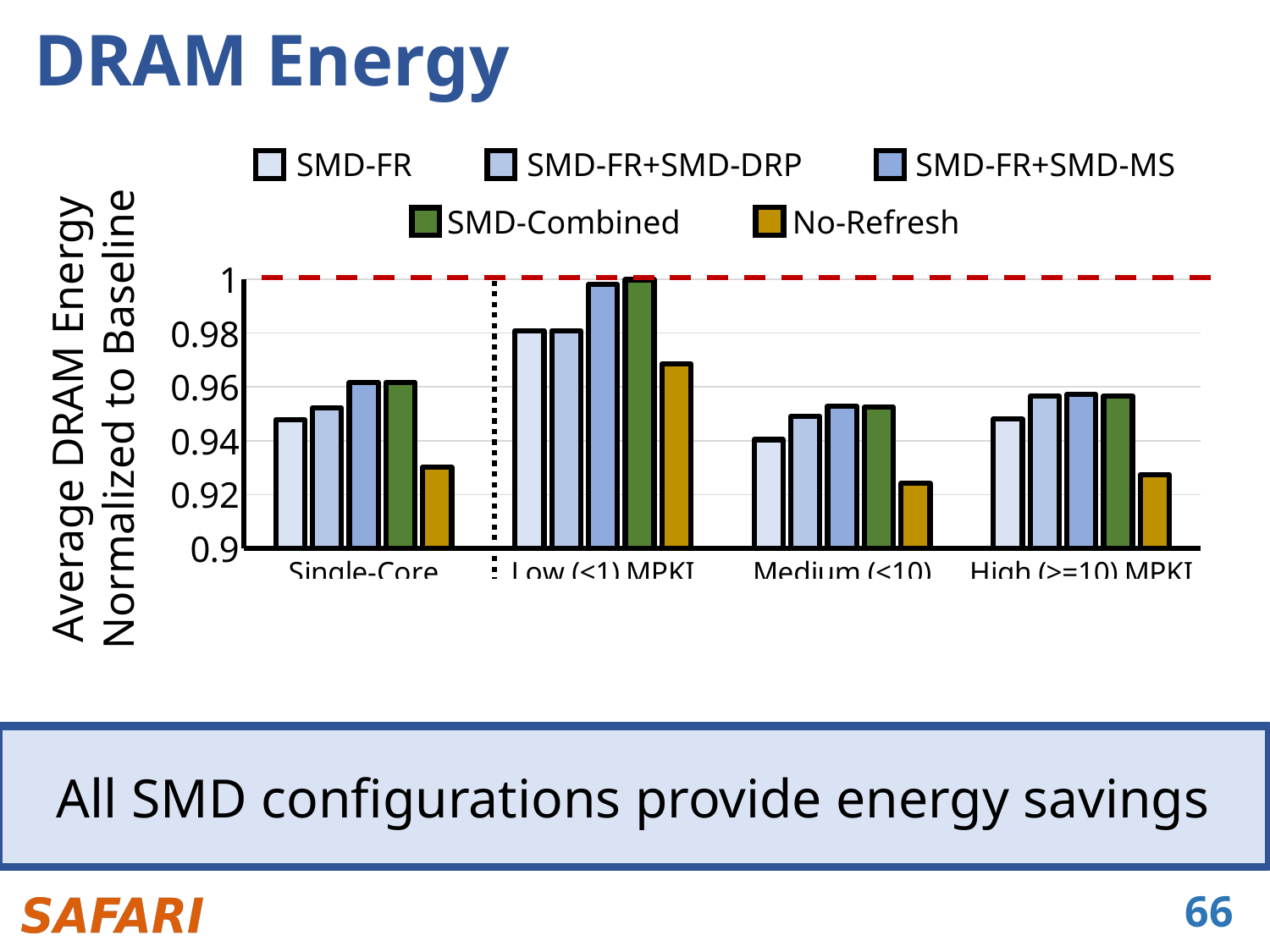
What kind of chart is shown on the slide? bar chart How many categories are shown along the x axis? 4 How many series does the legend list? 5 In which category is the SMD-FR bar the highest? Low (<1) MPKI Is the value for No-Refresh in the Low (<1) MPKI category greater or less than 0.96? greater Is the value for No-Refresh in the Single-Core category greater or less than 0.94? less Which is larger: SMD-FR in the Low (<1) MPKI category or SMD-FR in the Single-Core category? SMD-FR in Low (<1) MPKI Which series has the lowest value in the Single-Core category? No-Refresh What is the y-axis title of the chart? Average DRAM Energy Normalized to Baseline Is the value for SMD-FR+SMD-MS in the Low (<1) MPKI category greater or less than 0.98? greater